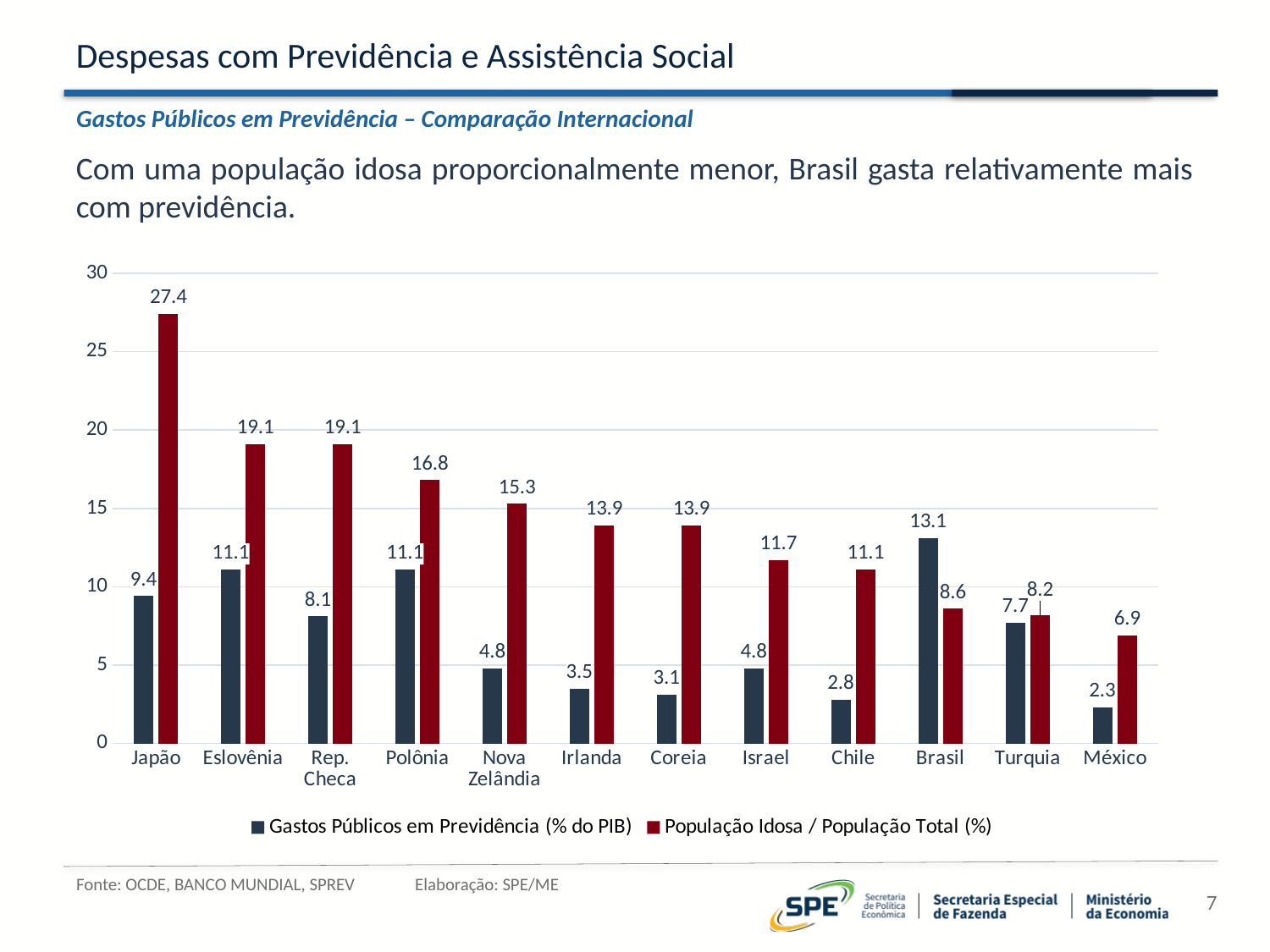
What is the difference between the População Idosa / População Total (%) values for Japão and Eslovênia? 8.3 What is the difference between the two series values for Brasil (Gastos Públicos em Previdência minus População Idosa / População Total)? 4.5 What is the value of Gastos Públicos em Previdência (% do PIB) for Brasil? 13.1 Which country has the highest value for Gastos Públicos em Previdência (% do PIB)? Brasil How many series does the chart legend list? 2 What is the value of População Idosa / População Total (%) for Japão? 27.4 Which country has the highest value for População Idosa / População Total (%)? Japão How many countries are shown on the x axis of the chart? 12 What type of chart is shown on the slide? Bar chart For Chile, which is larger: Gastos Públicos em Previdência (% do PIB) or População Idosa / População Total (%)? População Idosa / População Total (%) What is the value of Gastos Públicos em Previdência (% do PIB) for México? 2.3 Which country has the lowest value for Gastos Públicos em Previdência (% do PIB)? México